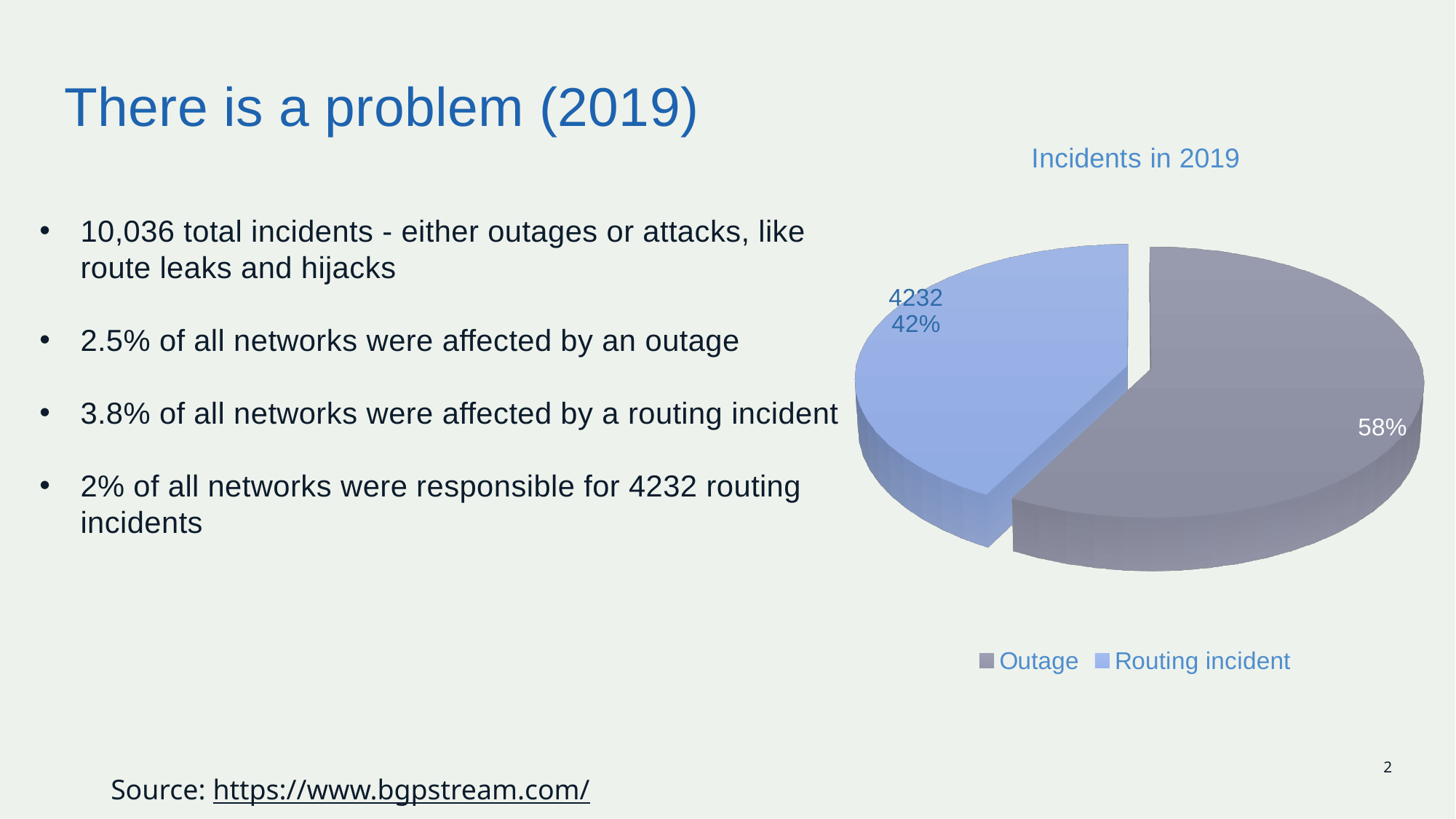
What kind of chart is shown on the slide? pie chart Which category has the smallest slice of the pie? Routing incident What share of the pie does the Routing incident slice represent? 42% What is the title of the chart? Incidents in 2019 What colour is the Routing incident slice in the pie chart? light blue What is the number of incidents shown for the Routing incident slice? 4232 How many slices does the pie chart have? 2 Which category has the largest slice of the pie? Outage How many entries does the chart legend list? 2 By how many percentage points does the Outage share exceed the Routing incident share? 16 Which is larger, the Outage slice or the Routing incident slice? Outage What share of the pie does the Outage slice represent? 58%